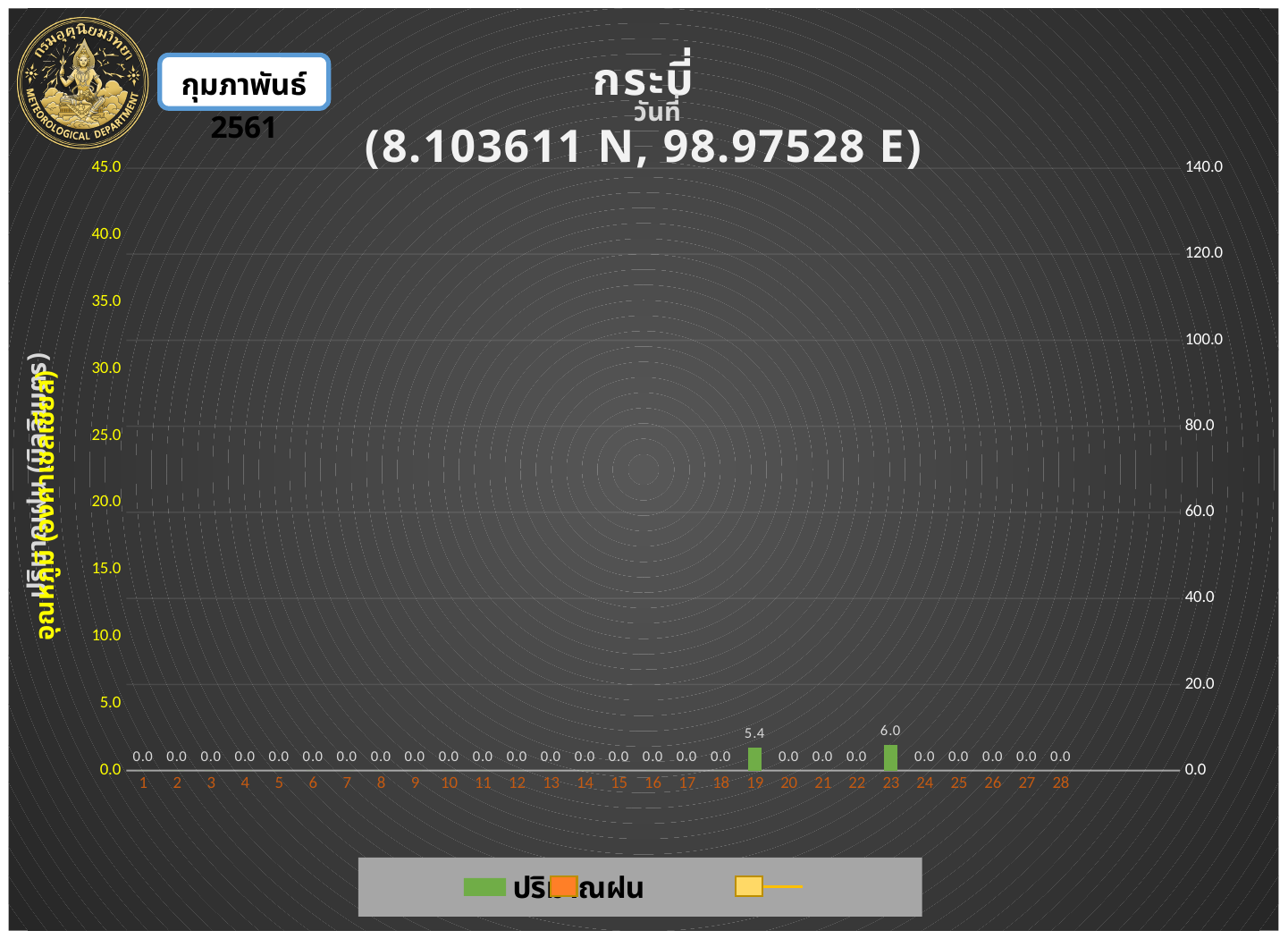
What kind of chart is shown on the slide? bar chart What is the total rainfall for days 19 and 23 combined? 11.4 What are the coordinates shown in the chart title? 8.103611 N, 98.97528 E What is the rainfall value shown for day 23? 6.0 What is the rainfall value shown for day 10? 0.0 Which day has the highest rainfall value? 23 How many days are shown on the x axis? 28 What is the rainfall value shown for day 19? 5.4 Is the rainfall value for day 23 greater or less than 20.0 on the right axis? less Which has the larger rainfall value, day 19 or day 23? day 23 What is the difference between the rainfall values for day 23 and day 19? 0.6 How many days have a non-zero rainfall value? 2